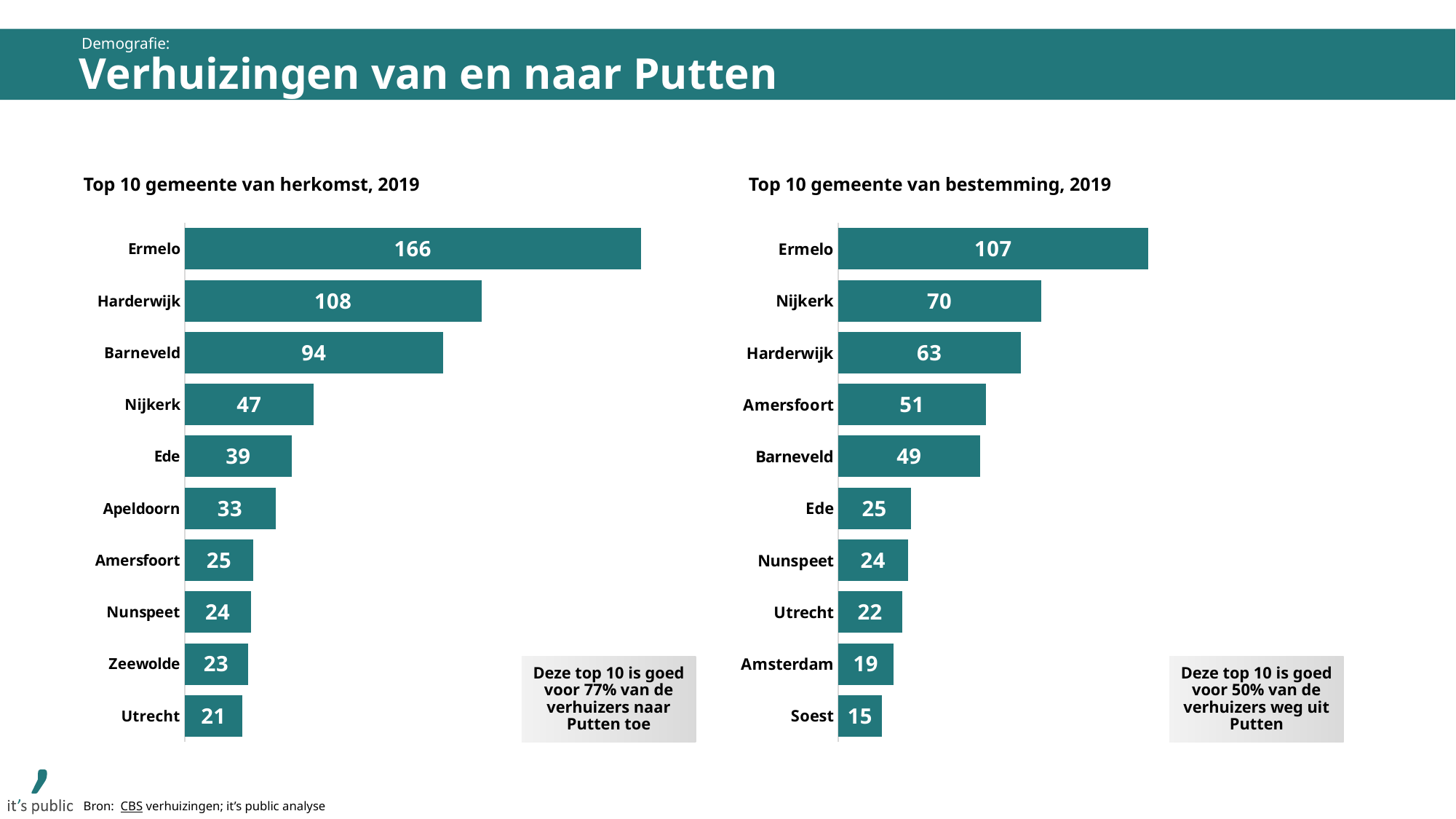
In the chart 'Top 10 gemeente van herkomst, 2019', what is the value for Harderwijk? 108 How many gemeenten are shown in the chart 'Top 10 gemeente van herkomst, 2019'? 10 In the chart 'Top 10 gemeente van herkomst, 2019', what is the value for Zeewolde? 23 What kind of chart is 'Top 10 gemeente van bestemming, 2019'? Bar chart In the chart 'Top 10 gemeente van herkomst, 2019', what is the difference between the values for Ermelo and Harderwijk? 58 According to the text box next to the chart 'Top 10 gemeente van bestemming, 2019', what share of the verhuizers weg uit Putten does this top 10 account for? 50% In the chart 'Top 10 gemeente van bestemming, 2019', what is the value for Amersfoort? 51 In the chart 'Top 10 gemeente van bestemming, 2019', what is the difference between the values for Nijkerk and Harderwijk? 7 In the chart 'Top 10 gemeente van bestemming, 2019', which gemeente has the lowest value? Soest In the chart 'Top 10 gemeente van herkomst, 2019', which gemeente has the highest value? Ermelo In the chart 'Top 10 gemeente van bestemming, 2019', which is larger: the value for Barneveld or the value for Ede? Barneveld In the chart 'Top 10 gemeente van herkomst, 2019', which is larger: the value for Nijkerk or the value for Ede? Nijkerk